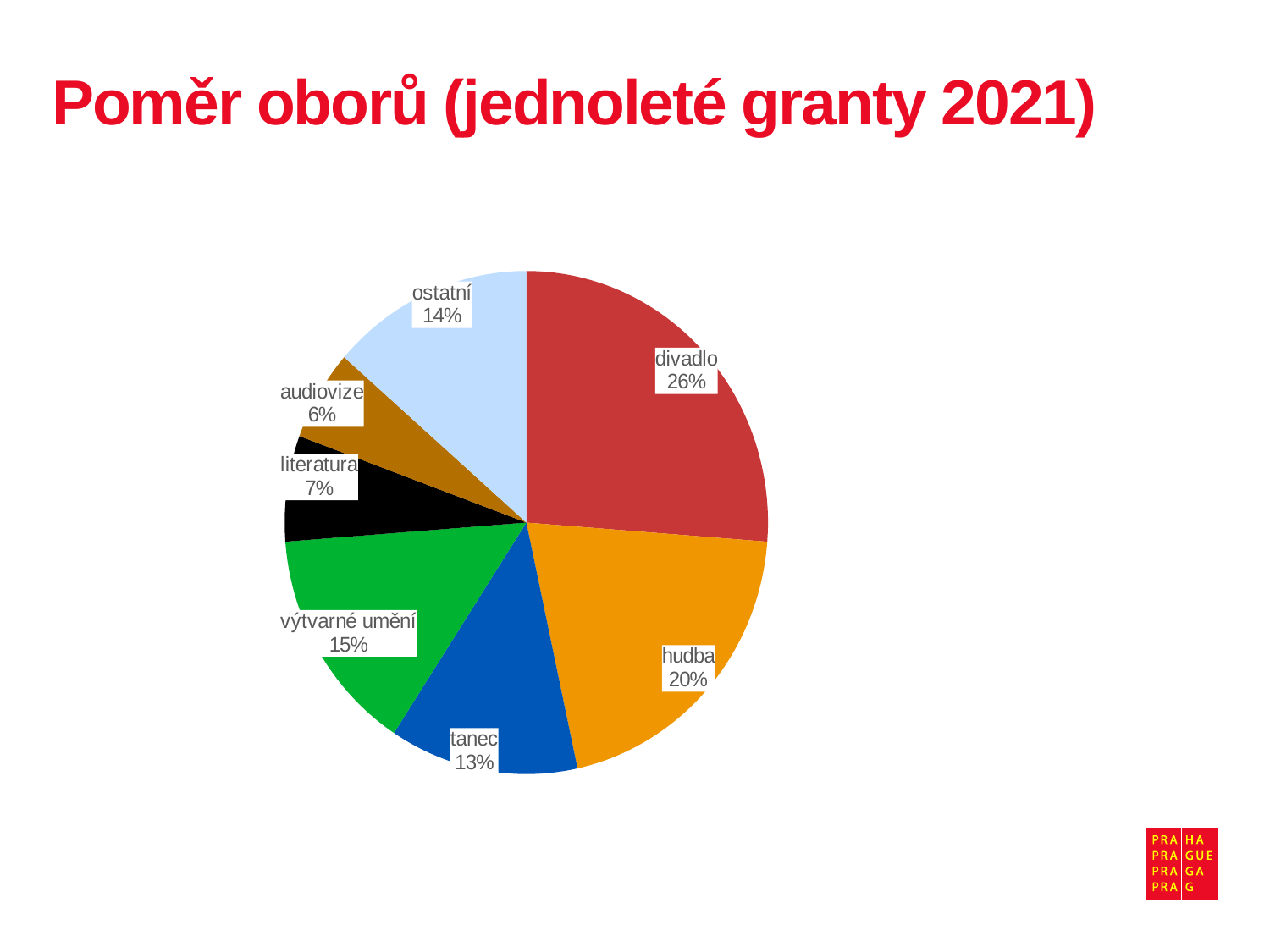
What share of the pie does výtvarné umění have? 15% What share of the pie does audiovize have? 6% Which category has the largest slice of the pie? divadlo How many categories are shown in the pie chart? 7 What is the difference in percentage points between ostatní and literatura? 7 Which category has the smallest slice of the pie? audiovize What share of the pie does hudba have? 20% What is the difference in percentage points between divadlo and hudba? 6 What is the title of the slide? Poměr oborů (jednoleté granty 2021) Which is larger, the share for tanec or the share for výtvarné umění? výtvarné umění What kind of chart is shown on the slide? pie chart What share of the pie does divadlo have? 26%